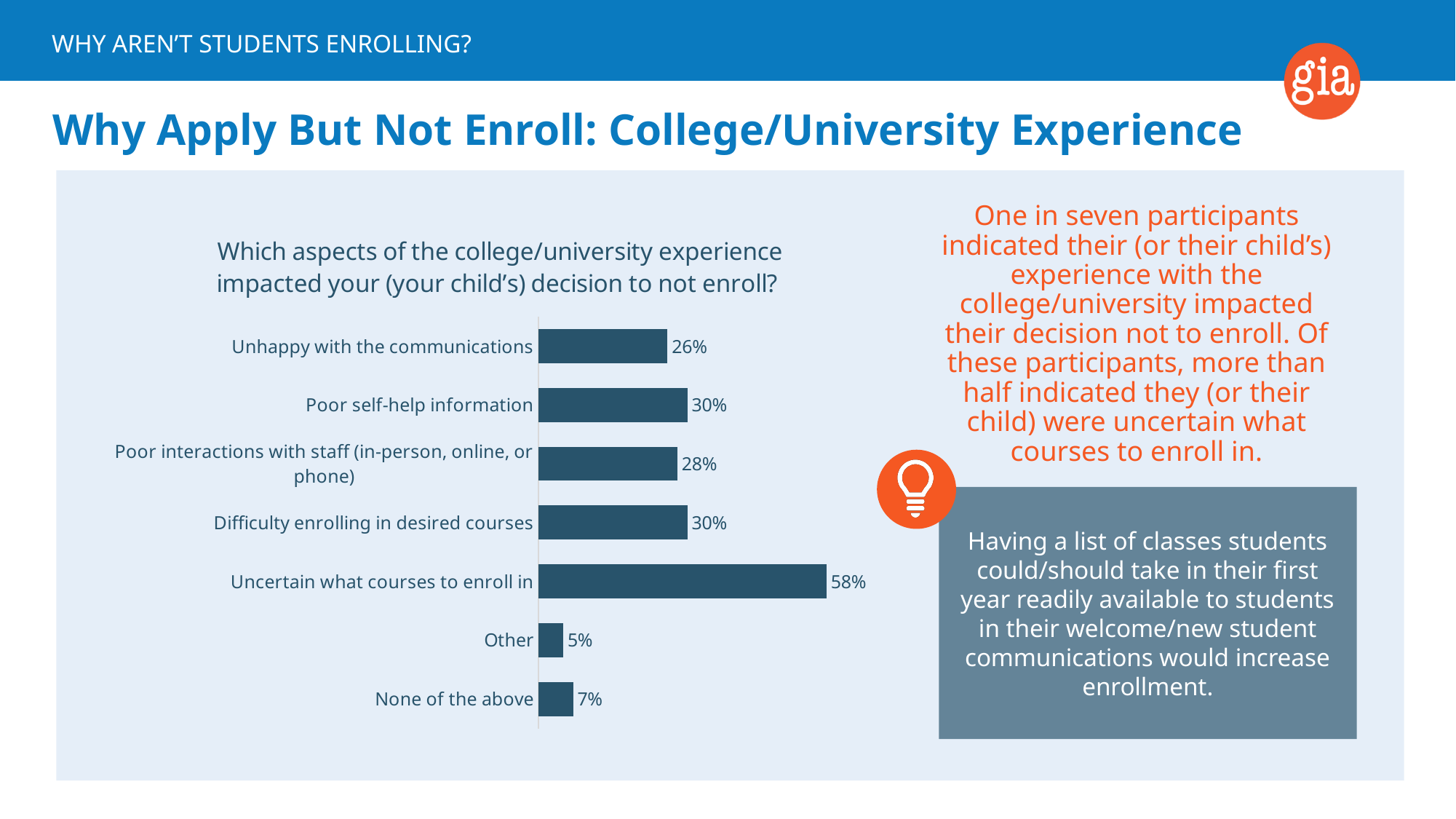
What percentage selected "Poor interactions with staff (in-person, online, or phone)"? 28% Which category has the highest value? Uncertain what courses to enroll in How many categories are shown in the chart? 7 What percentage of respondents were uncertain what courses to enroll in? 58% What is the difference between "None of the above" and "Other"? 2% What question does the chart title ask? Which aspects of the college/university experience impacted your (your child's) decision to not enroll? What is the value for "None of the above"? 7% What is the value for "Unhappy with the communications"? 26% What is the difference between "Uncertain what courses to enroll in" and "Poor self-help information"? 28% Which category has the lowest value? Other What kind of chart is shown on the slide? Bar chart Which is larger: "Unhappy with the communications" or "Poor interactions with staff (in-person, online, or phone)"? Poor interactions with staff (in-person, online, or phone)